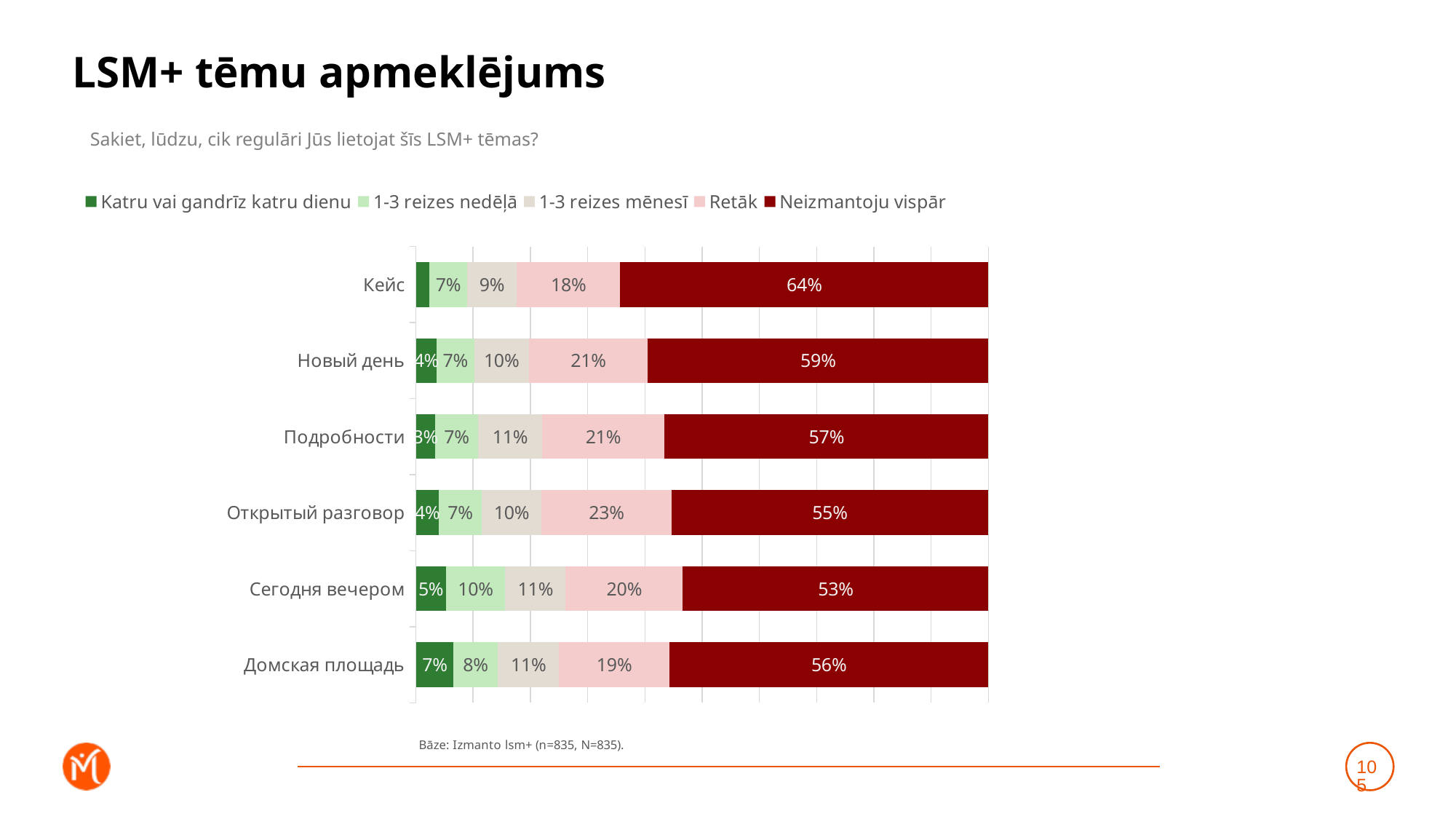
What is the "1-3 reizes nedēļā" value for Сегодня вечером? 10% How many categories (programmes) are shown in the chart? 6 What is the "Katru vai gandrīz katru dienu" value for Домская площадь? 7% Which has a larger "Retāk" share, Новый день or Домская площадь? Новый день What is the "Retāk" value for Открытый разговор? 23% Which category has the highest "Katru vai gandrīz katru dienu" share? Домская площадь How many series does the legend list? 5 What kind of chart is shown on the slide? Stacked bar chart What is the difference in the "Neizmantoju vispār" share between Кейс and Сегодня вечером? 11 percentage points Which category has the lowest "Neizmantoju vispār" share? Сегодня вечером Which category has the highest "Neizmantoju vispār" share? Кейс What percentage of respondents answered "Neizmantoju vispār" for Кейс? 64%